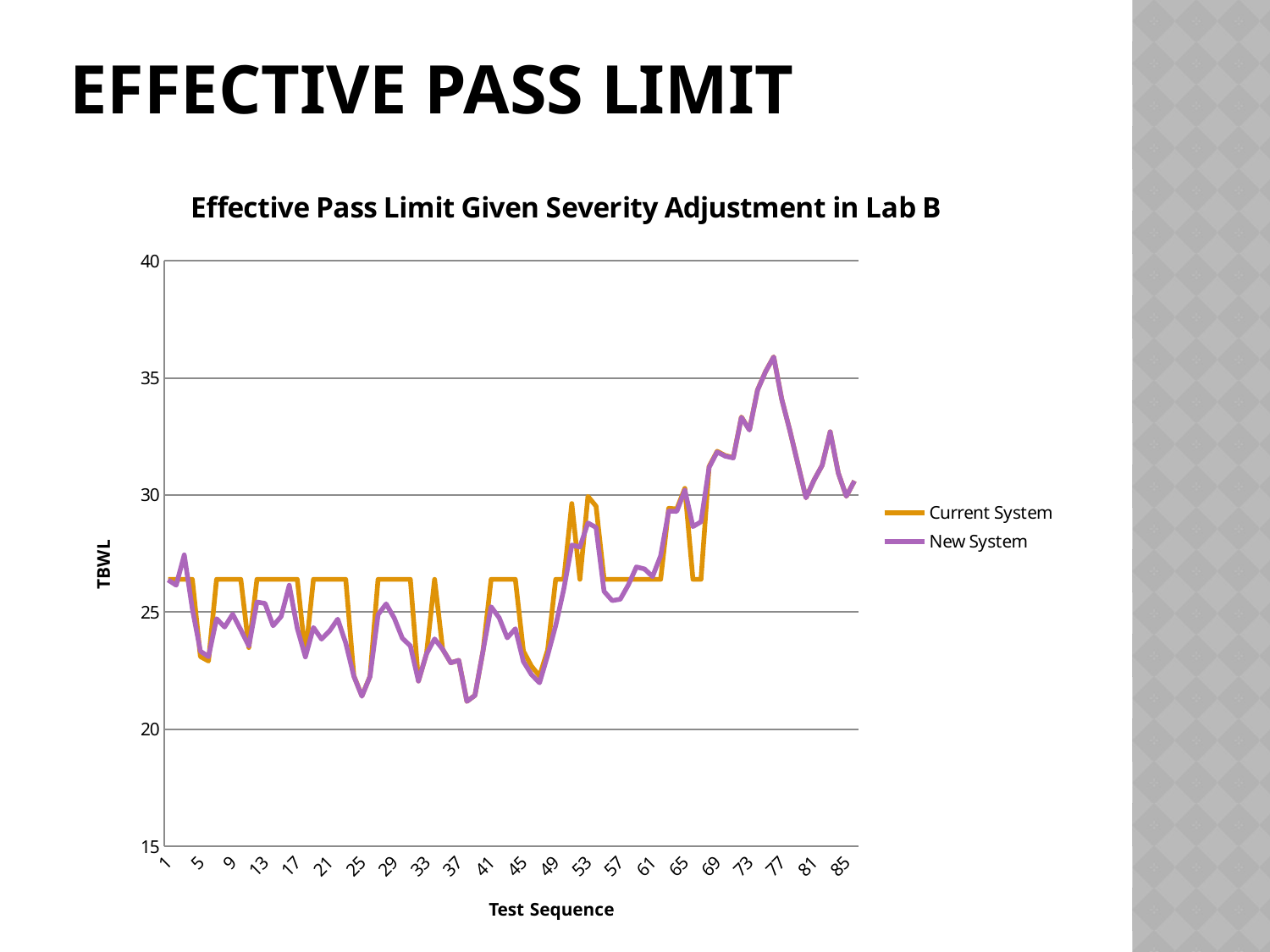
What is the title of the chart? Effective Pass Limit Given Severity Adjustment in Lab B Is the Current System value at test sequence 9 greater or less than 30? less Is the Current System value at test sequence 53 greater or less than 25? greater What are the two series named in the legend? Current System and New System How many series does the legend list? 2 Is the New System value at test sequence 81 greater or less than 25? greater What kind of chart is shown on the slide? Line chart Does the New System line rise or fall between test sequence 69 and test sequence 77? Rise